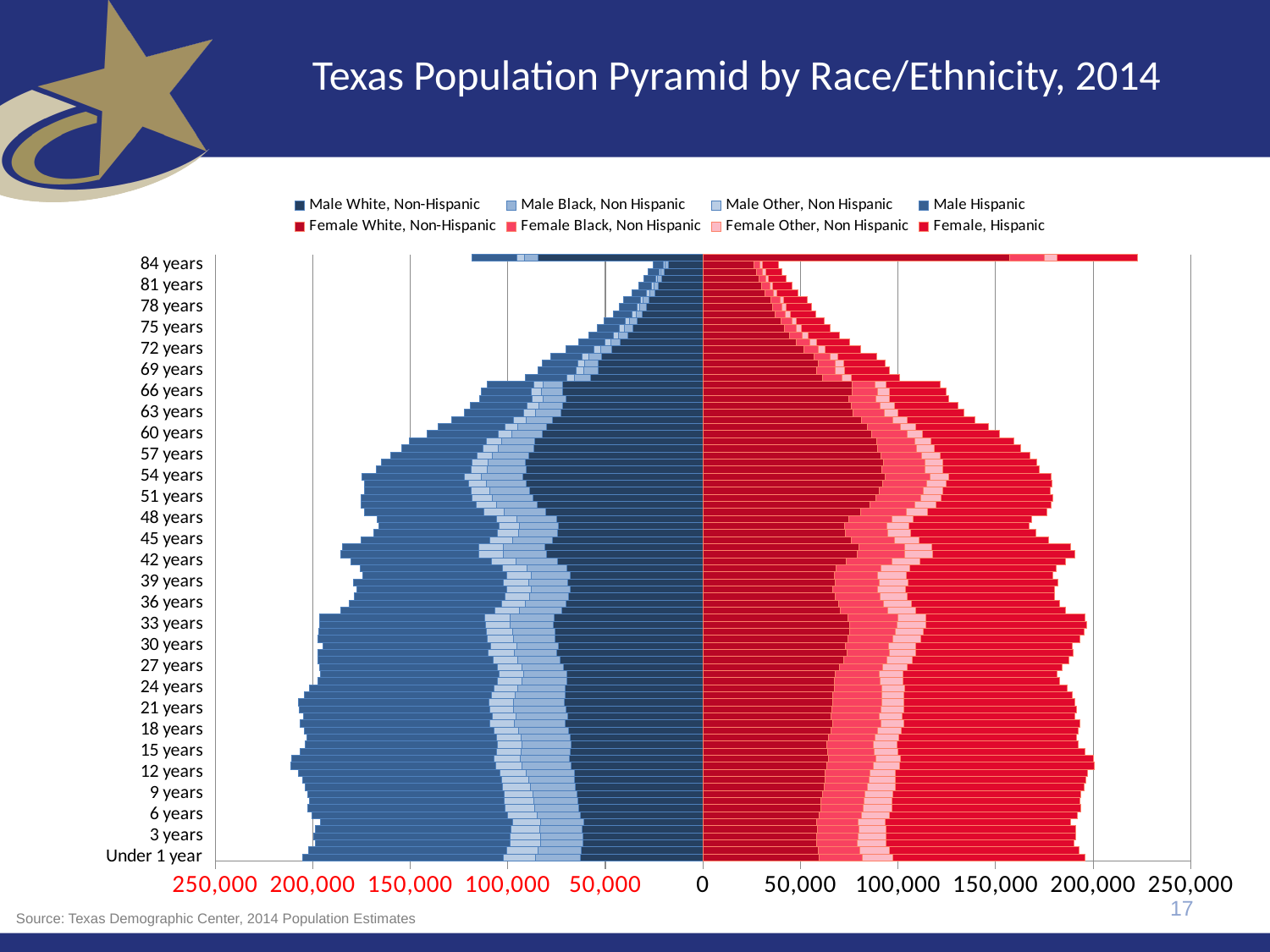
Which is larger, the total male bar for 42 years or the total male bar for 84 years? 42 years What is the largest value shown on the horizontal axis? 250,000 How many series does the legend list? 8 What is the title of the chart? Texas Population Pyramid by Race/Ethnicity, 2014 Which is larger at 84 years, the total male bar or the total female bar? Female Is the total female bar for 72 years greater or less than 100,000? less What kind of chart is shown on the slide? Bar chart (population pyramid) Is the total male bar for 81 years greater or less than 50,000? less Is the total male bar for 12 years greater or less than 200,000? greater